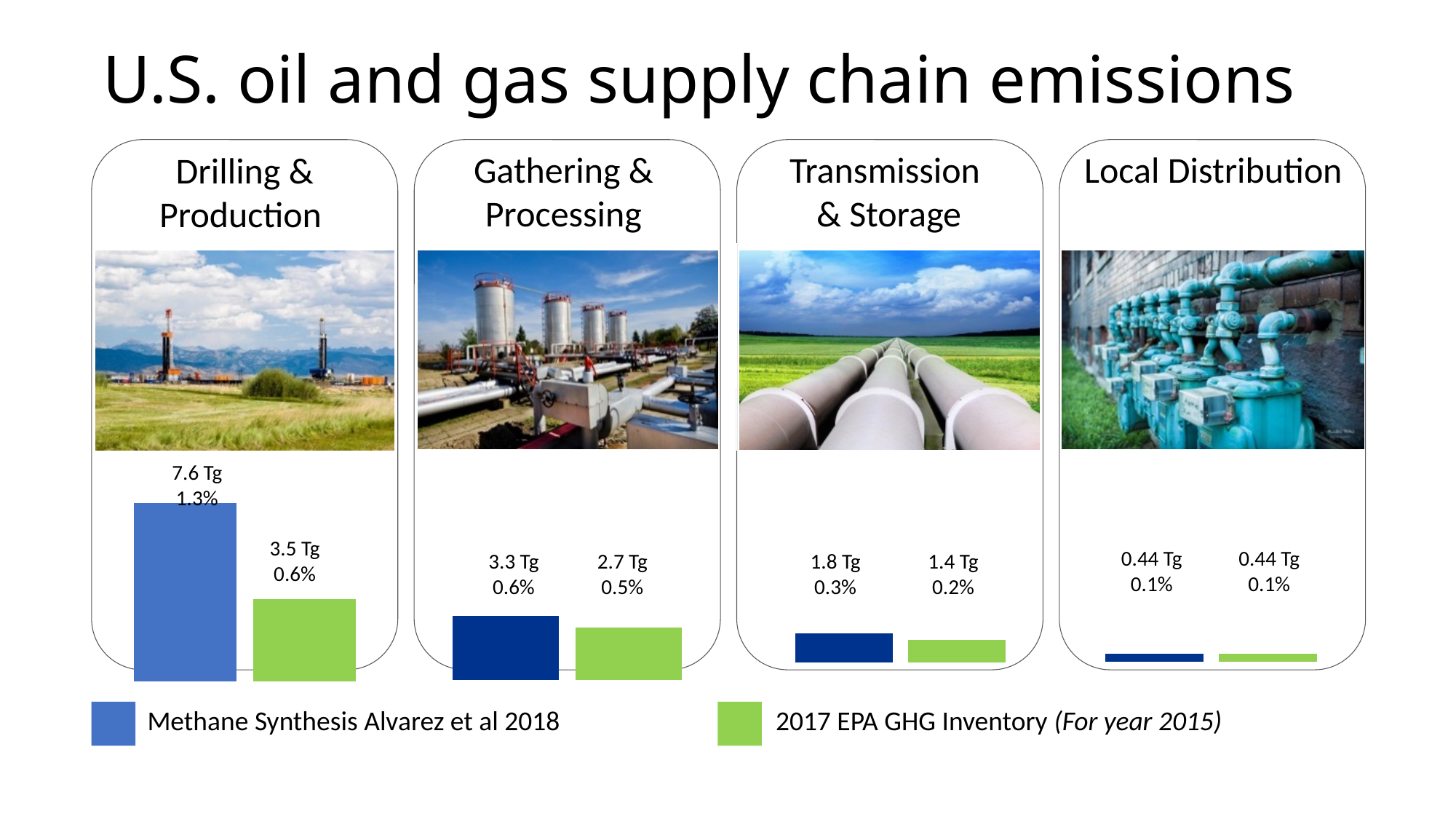
How many series does the legend at the bottom of the slide list? 2 What kind of chart is used in each of the four segment panels? Bar chart In the Local Distribution chart, what percentage is shown for Methane Synthesis Alvarez et al 2018? 0.1% In the Drilling & Production chart, what is the value for Methane Synthesis Alvarez et al 2018? 7.6 Tg In the Gathering & Processing chart, which is larger: Methane Synthesis Alvarez et al 2018 or the 2017 EPA GHG Inventory? Methane Synthesis Alvarez et al 2018 Across the four charts, which segment has the highest Methane Synthesis Alvarez et al 2018 value? Drilling & Production In the Transmission & Storage chart, what is the difference in Tg between the two bars? 0.4 Tg In the Gathering & Processing chart, what is the value for Methane Synthesis Alvarez et al 2018? 3.3 Tg In the Transmission & Storage chart, what is the value for the 2017 EPA GHG Inventory? 1.4 Tg Across the four charts, which segment has the lowest 2017 EPA GHG Inventory value? Local Distribution In the Drilling & Production chart, what is the value for the 2017 EPA GHG Inventory? 3.5 Tg In the Drilling & Production chart, what is the difference in Tg between the Methane Synthesis Alvarez et al 2018 value and the 2017 EPA GHG Inventory value? 4.1 Tg